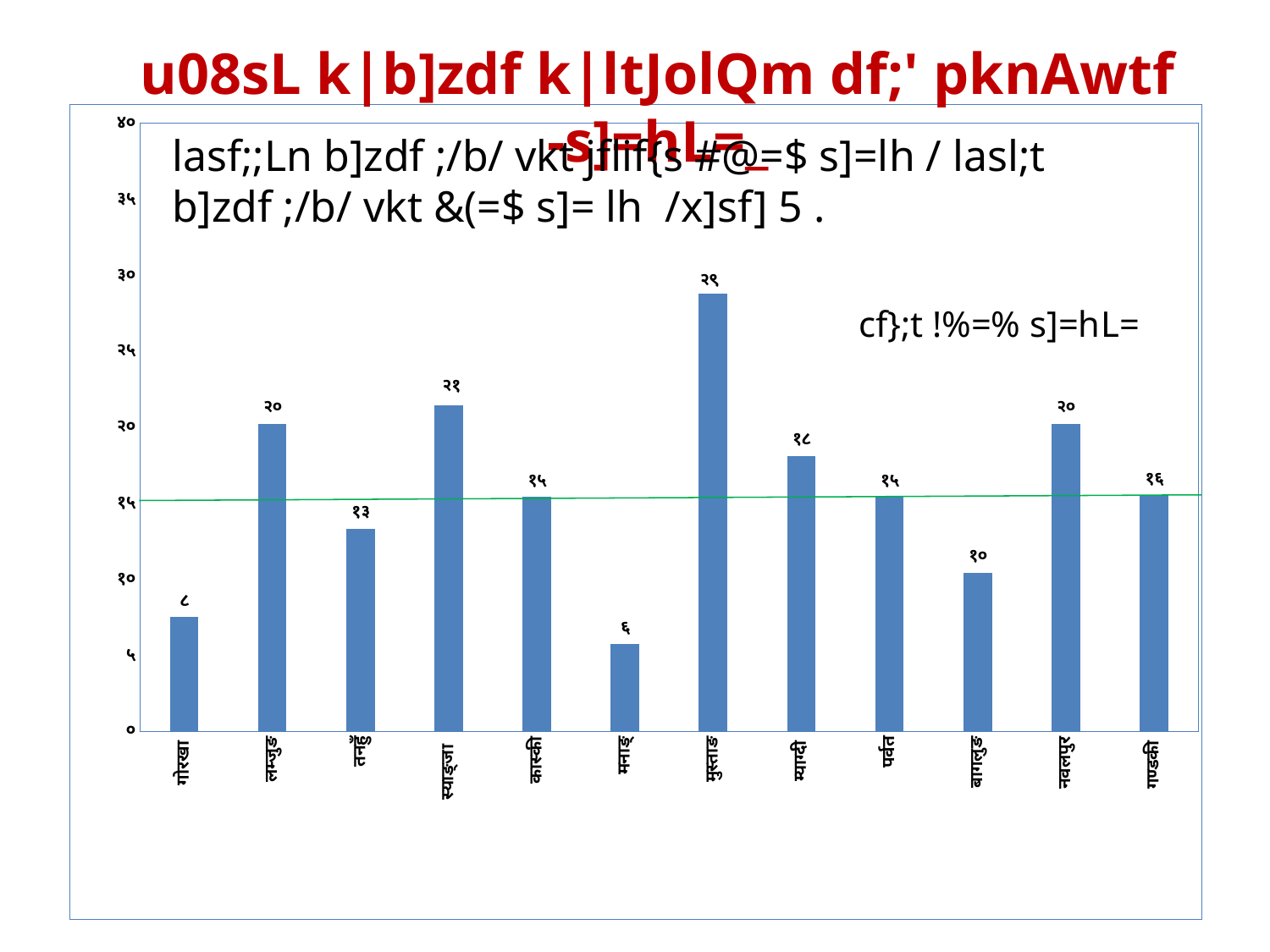
What is the value shown for बागलुङ? १० Which category has the lowest value in the chart? मनाङ What colour are the bars in the chart? blue Which has a larger value, म्याग्दी or गण्डकी? म्याग्दी How many categories are plotted on the x axis of the chart? 12 What is the difference between the values for स्याङ्जा and तनहुँ? ८ Which category has the highest value in the chart? मुस्ताङ What is the difference between the values for मुस्ताङ and मनाङ? २३ What type of chart is shown on the slide? bar chart What is the value shown for गोरखा? ८ What is the value shown for स्याङ्जा? २१ What is the value shown for मुस्ताङ? २९